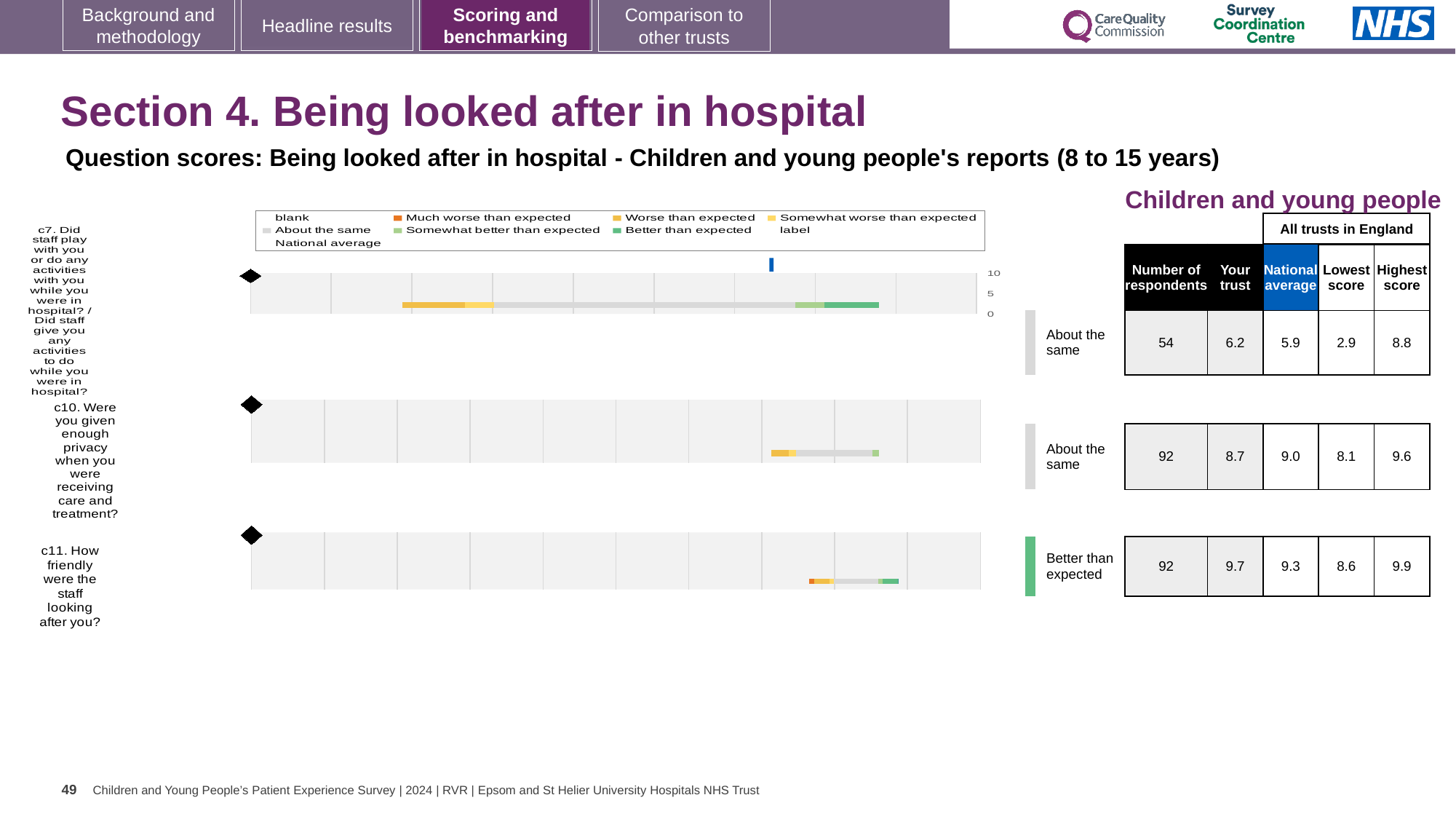
What kind of chart is used to show the question scores for c7, c10 and c11? bar chart What is the 'Your trust' score for question c7 (Did staff play with you or do any activities with you while you were in hospital?)? 6.2 What is the national average score for question c10 (Were you given enough privacy when you were receiving care and treatment?)? 9.0 What benchmark category is shown for question c7? About the same What benchmark category is shown for question c11? Better than expected Which question has the highest 'Your trust' score? c11. How friendly were the staff looking after you? Which question has the lowest 'Your trust' score? c7. Did staff play with you or do any activities with you while you were in hospital? How many respondents answered question c11 (How friendly were the staff looking after you?)? 92 For question c10, which is larger: the 'Your trust' score or the national average? National average How many questions (bars) are plotted on the slide? 3 For question c11, what is the difference between the highest score and the lowest score across all trusts in England? 1.3 For question c7, how much higher is the 'Your trust' score than the national average? 0.3